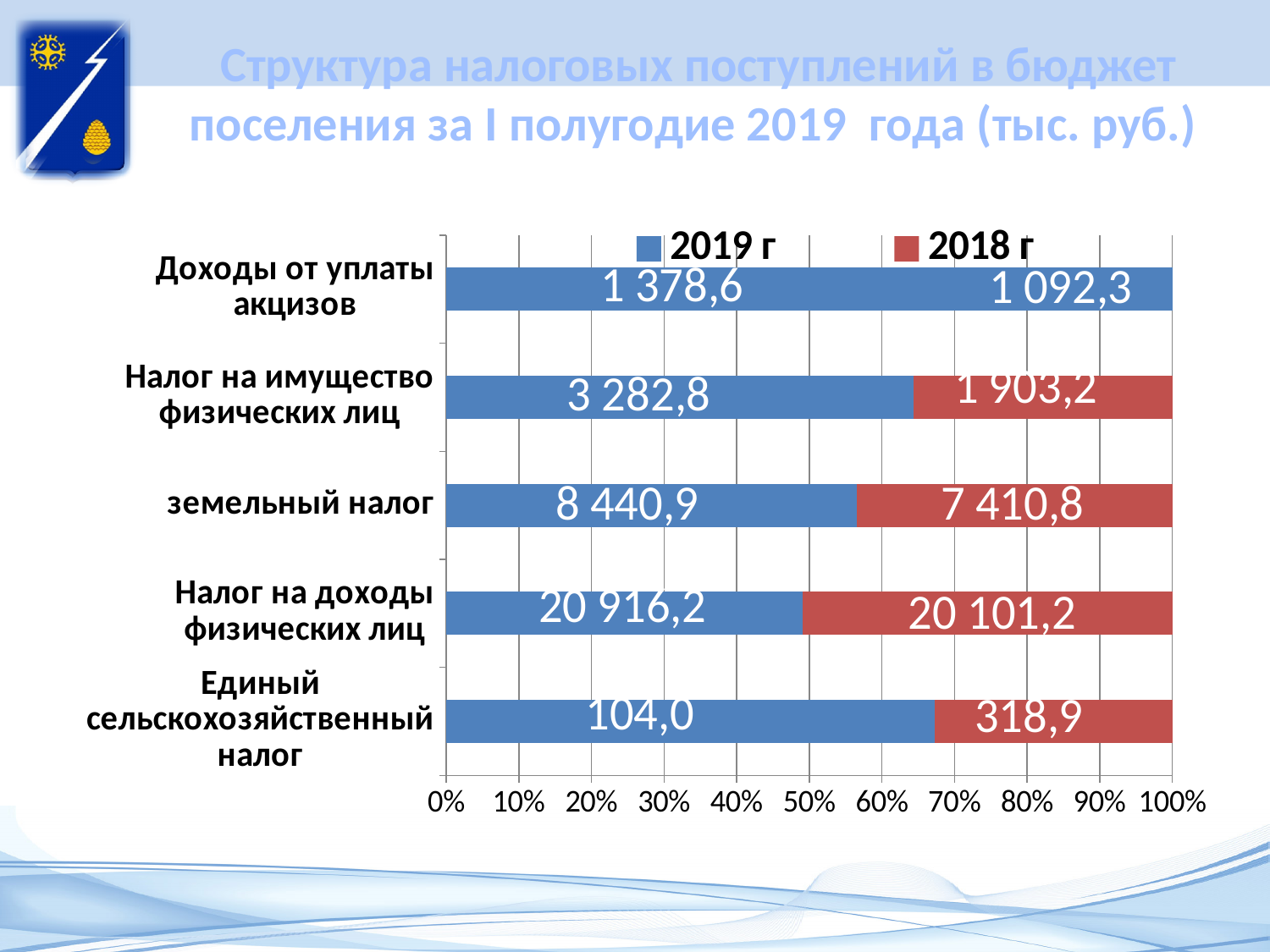
Which category has the lowest value in the 2019 г series? Единый сельскохозяйственный налог What is the difference between the 2019 г and 2018 г values for Налог на имущество физических лиц? 1 379,6 For Единый сельскохозяйственный налог, which series has the larger value, 2019 г or 2018 г? 2018 г What is the value for Единый сельскохозяйственный налог in the 2019 г series? 104,0 Which category has the highest value in the 2019 г series? Налог на доходы физических лиц How many categories are shown on the chart? 5 How many series does the legend list? 2 What is the value for Налог на имущество физических лиц in the 2018 г series? 1 903,2 What is the difference between the 2019 г and 2018 г values for земельный налог? 1 030,1 What kind of chart is shown on the slide? bar chart What is the value for Налог на доходы физических лиц in the 2018 г series? 20 101,2 What is the value for земельный налог in the 2019 г series? 8 440,9